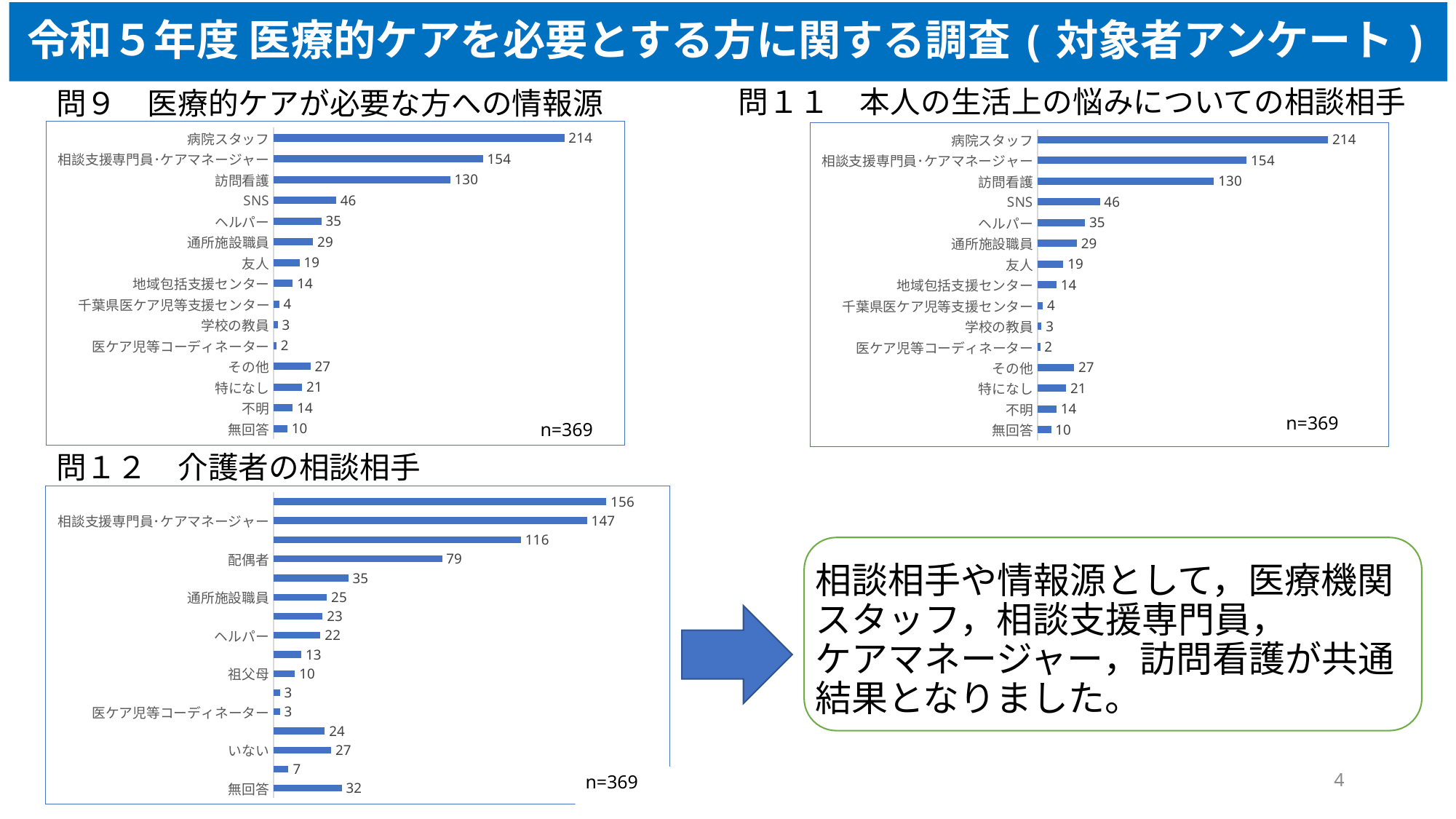
In the 問12 chart (介護者の相談相手), what is the value for 配偶者? 79 In the 問11 chart (本人の生活上の悩みについての相談相手), what is the value for SNS? 46 In the 問9 chart, which category has the lowest value? 医ケア児等コーディネーター In the 問9 chart, how many categories are plotted? 15 In the 問9 chart, what is the difference between the values for 病院スタッフ and 相談支援専門員・ケアマネージャー? 60 In the 問12 chart, what is the value for 無回答? 32 In the 問9 chart (医療的ケアが必要な方への情報源), what is the value for 病院スタッフ? 214 In the 問11 chart, what is the value for 無回答? 10 In the 問11 chart, which is larger, the value for ヘルパー or the value for 通所施設職員? ヘルパー In the 問9 chart, what is the value for 訪問看護? 130 What type of chart is the 問12 chart (介護者の相談相手)? bar chart In the 問9 chart, which category has the highest value? 病院スタッフ